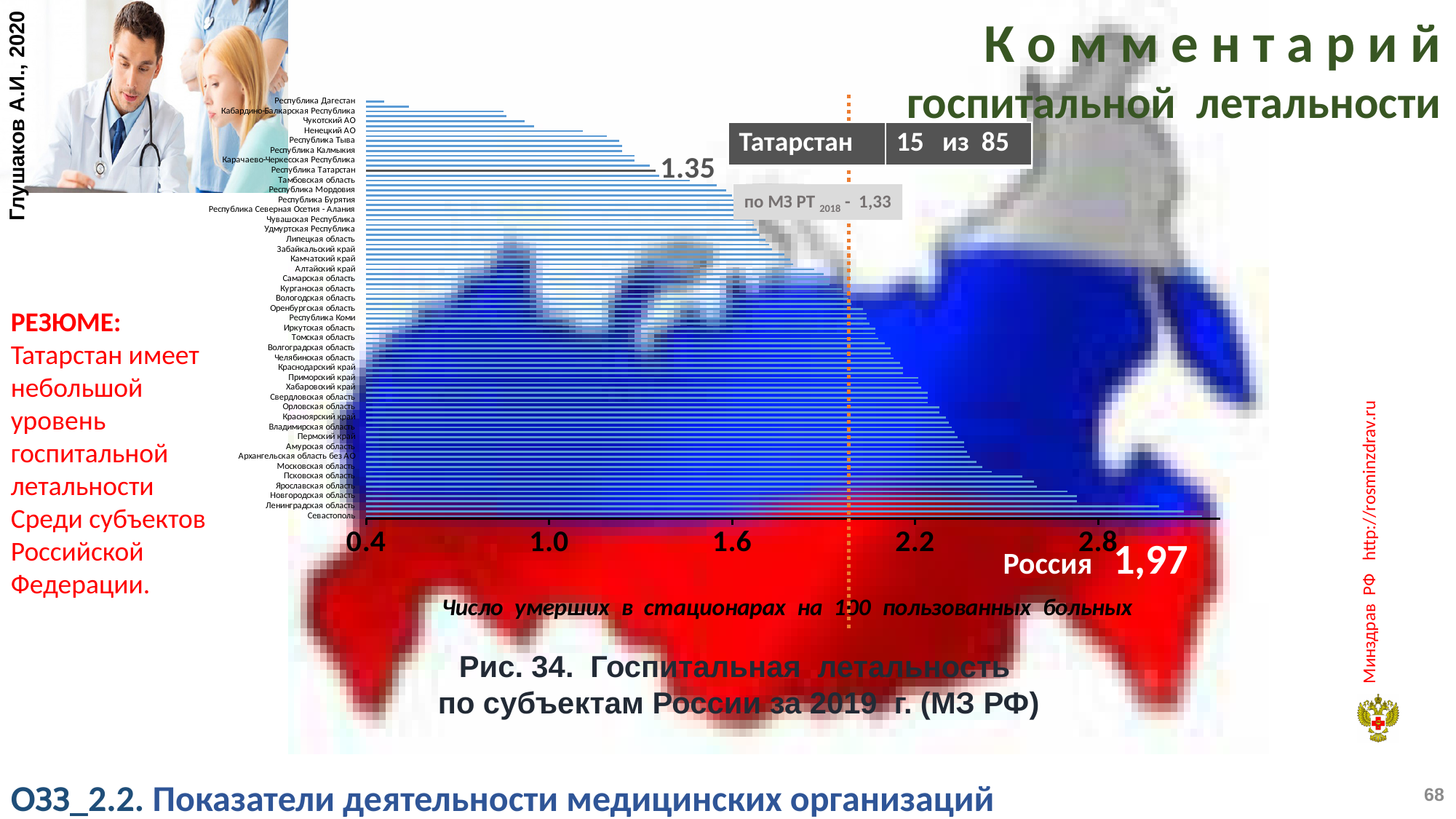
Which has the larger value, Республика Татарстан or Севастополь? Севастополь Which region has the shortest bar? Республика Дагестан What kind of chart is shown on the slide? bar chart Is the value for Республика Татарстан greater or less than 1.6? less Is the value for Республика Дагестан greater or less than 1.0? less What value is shown for Россия on the chart? 1,97 Which region has the longest bar? Севастополь Is the value for Ленинградская область greater or less than 2.2? greater Do the bar values increase or decrease going down the list of regions from top to bottom? increase What is the x-axis label of the chart? Число умерших в стационарах на 100 пользованных больных What value is labelled for Республика Татарстан? 1.35